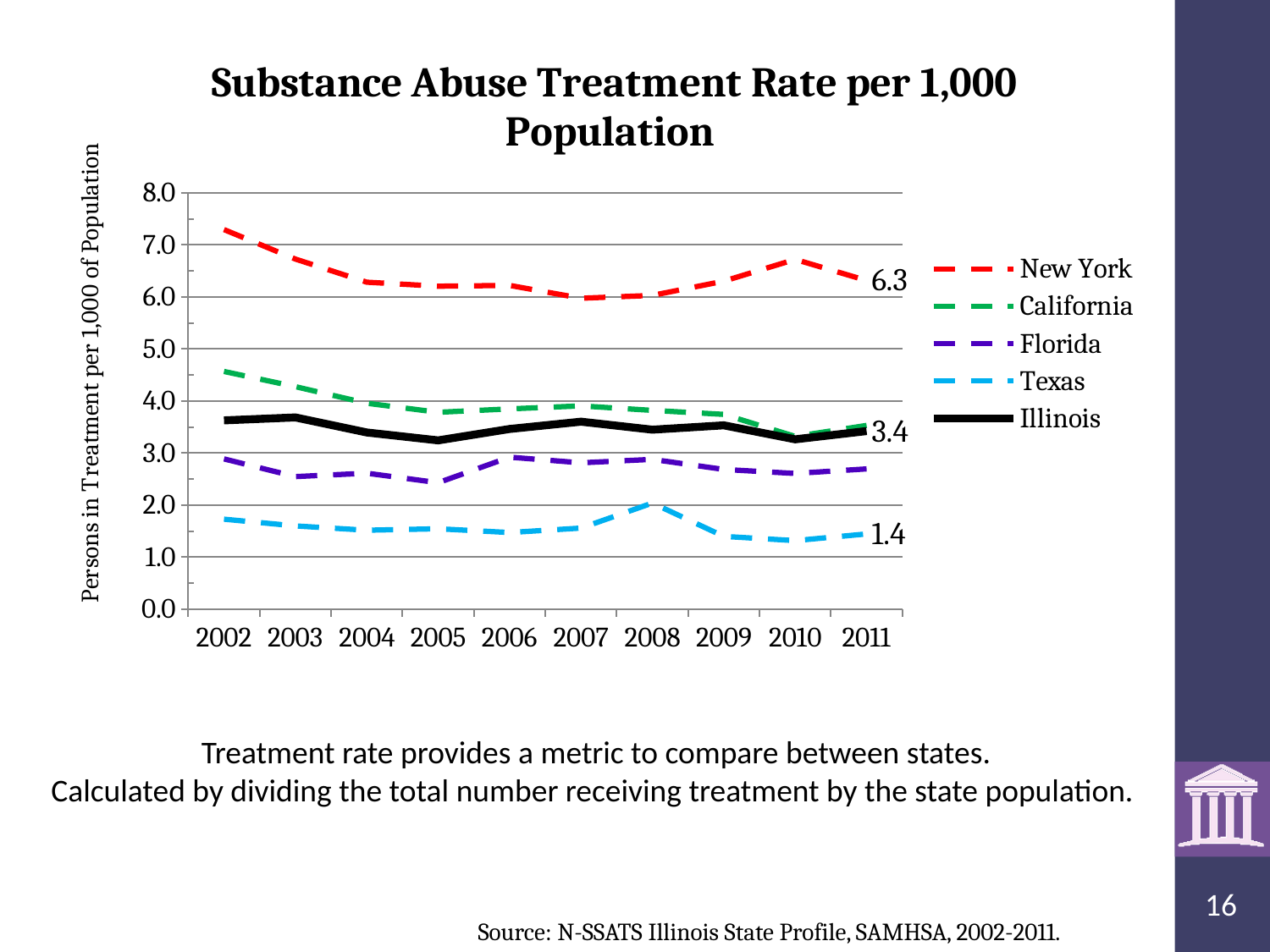
What kind of chart is shown on the slide? line chart Is the value for Florida in 2005 greater or less than 3.0? less Which state has the lowest treatment rate in 2011? Texas What is the difference between the New York and Illinois treatment rates in 2011? 2.9 What is the treatment rate for Illinois in 2011? 3.4 Is the value for New York in 2002 greater or less than 7.0? greater What is the treatment rate for New York in 2011? 6.3 How many series does the legend list? 5 Which state has the highest treatment rate in 2011? New York How many years are shown along the x axis? 10 Which is larger in 2002, the value for California or the value for Illinois? California What is the treatment rate for Texas in 2011? 1.4